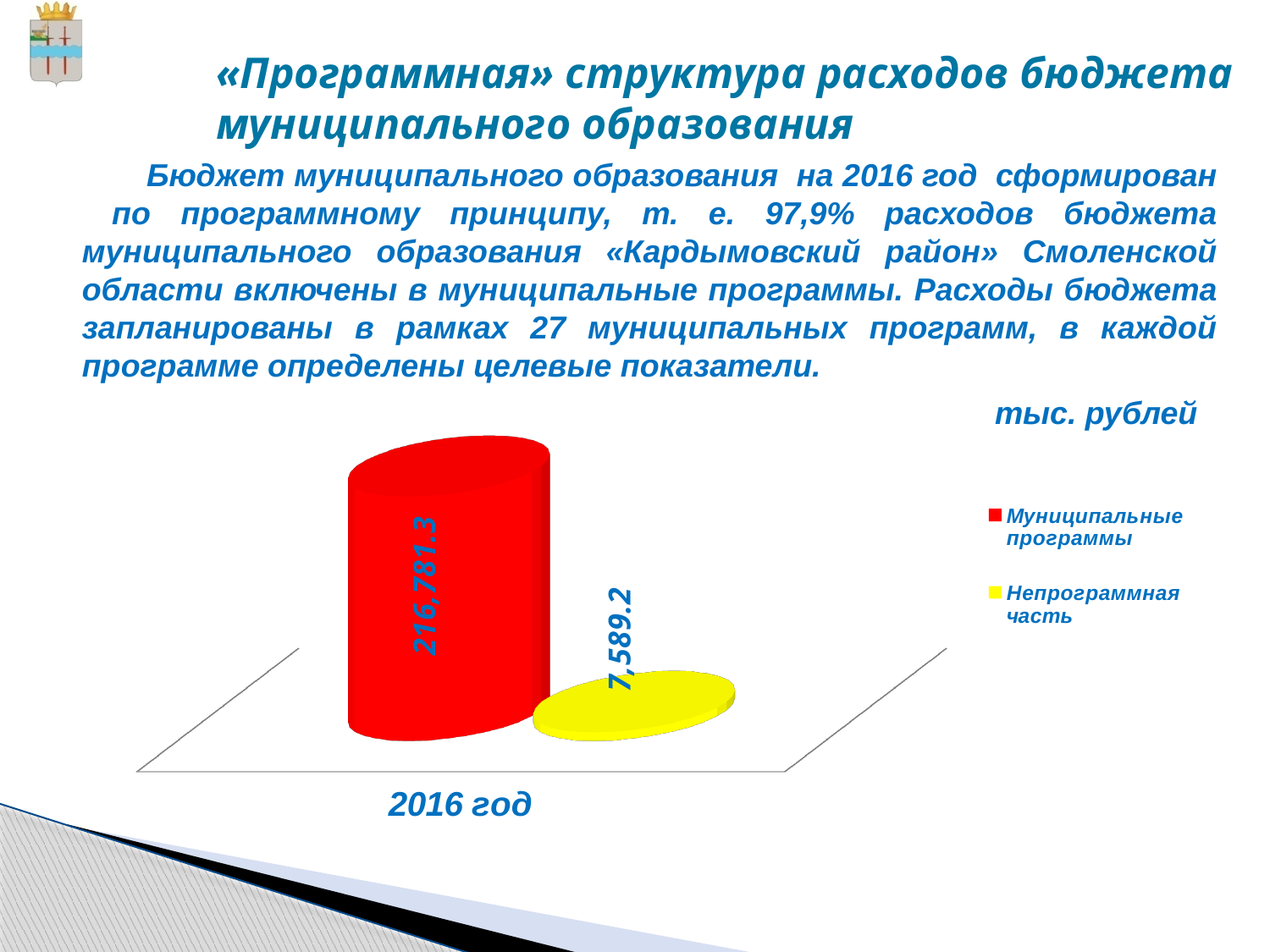
How many series does the legend list? 2 What is the value for Муниципальные программы in 2016 год? 216,781.3 What colour represents Непрограммная часть in the chart? yellow What is the difference between the values for Муниципальные программы and Непрограммная часть? 209,192.1 Which series has the higher value in 2016 год? Муниципальные программы Which series has the lower value in 2016 год? Непрограммная часть What is the combined total of Муниципальные программы and Непрограммная часть for 2016 год? 224,370.5 What kind of chart is shown on the slide? bar chart Is the value for Муниципальные программы larger or smaller than the value for Непрограммная часть? larger How many categories are shown on the x axis? 1 What is the value for Непрограммная часть in 2016 год? 7,589.2 What unit is stated for the chart values? тыс. рублей